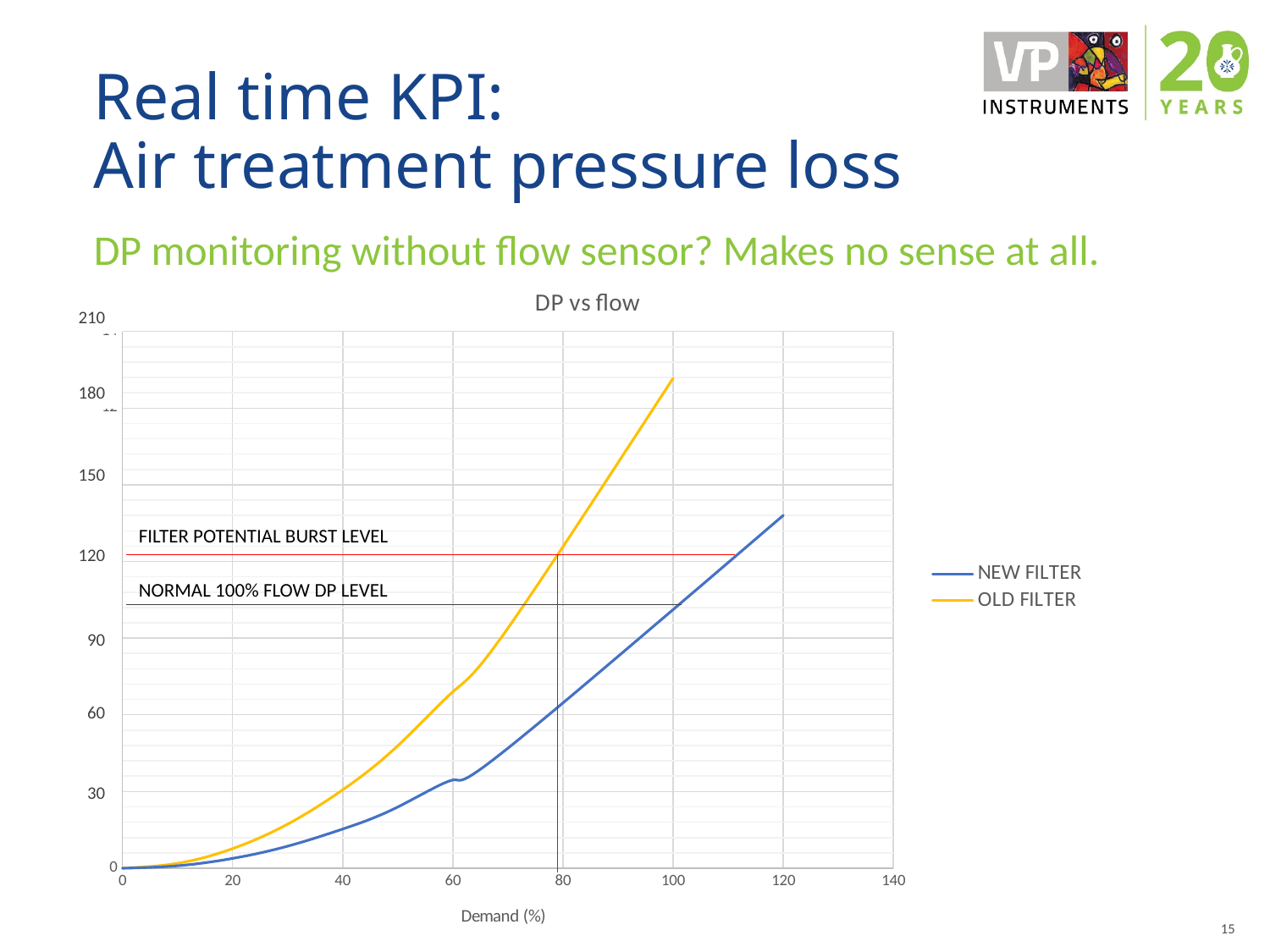
Is the NEW FILTER value at a demand of 100% greater or less than 120? less What kind of chart is shown on the slide? line chart What are the two series named in the legend of the DP vs flow chart? NEW FILTER and OLD FILTER Is the NEW FILTER value at a demand of 120% greater or less than 120? greater Is the OLD FILTER value at a demand of 80% greater or less than 90? greater What is the title of the chart on the slide? DP vs flow How many series does the legend of the DP vs flow chart list? 2 Do the values of the OLD FILTER series rise or fall as demand increases along the x axis? rise At a demand of 100%, which series has the higher value, NEW FILTER or OLD FILTER? OLD FILTER